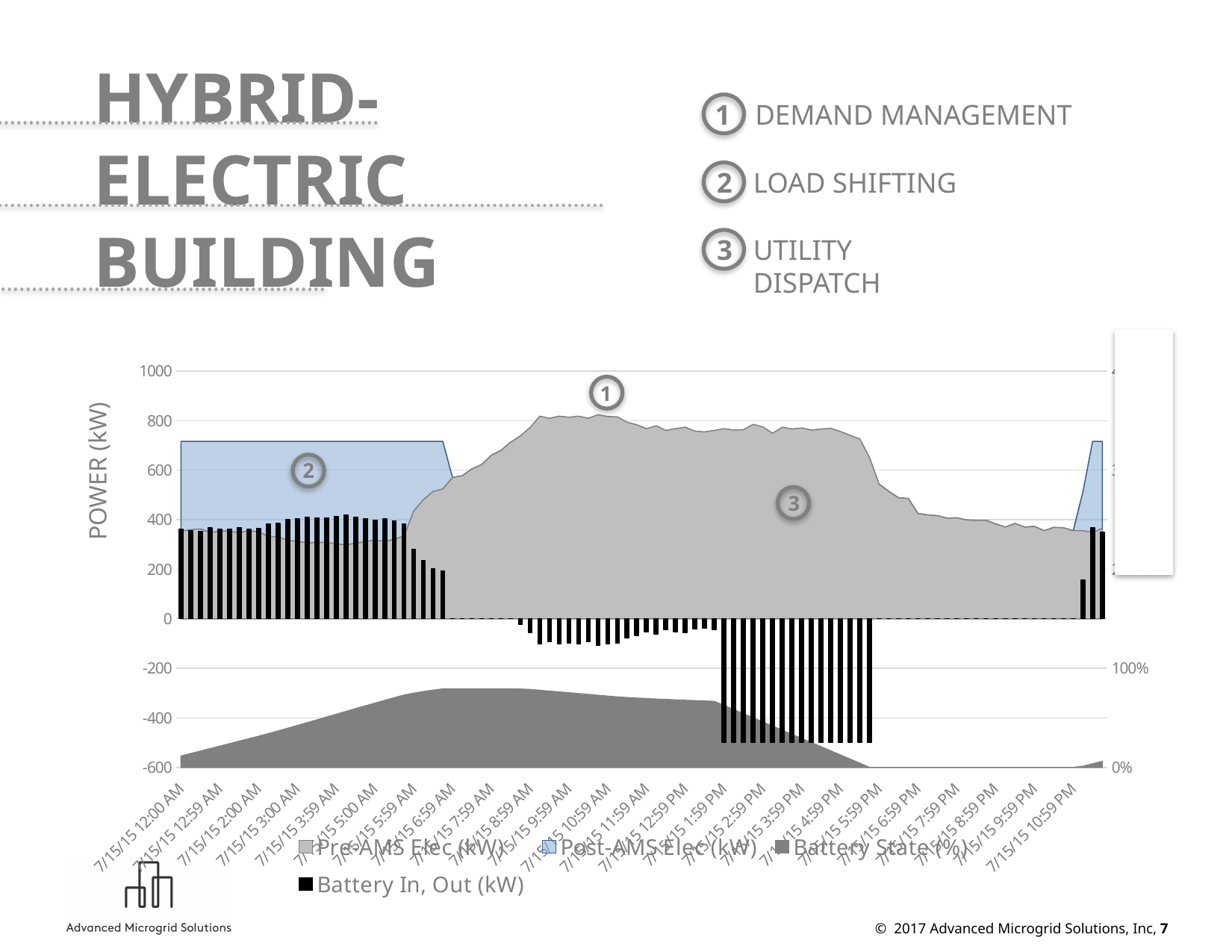
Is the value for Pre-AMS Elec (kW) at 7/15/15 12:00 AM greater or less than 600? less What kind of chart is shown on the slide? a combined area and bar chart Is the value for Post-AMS Elec (kW) at 7/15/15 12:00 AM greater or less than 600? greater Which is larger for Pre-AMS Elec (kW): the value at 7/15/15 9:59 AM or at 7/15/15 12:00 AM? 7/15/15 9:59 AM How many series does the chart legend list? 4 At 7/15/15 12:00 AM, which series has the larger value: Pre-AMS Elec (kW) or Post-AMS Elec (kW)? Post-AMS Elec (kW) Is the value for Battery In, Out (kW) at 7/15/15 2:59 PM greater or less than -400? less What is the label on the left vertical axis of the chart? POWER (kW) Which series in the legend is shown in blue? Post-AMS Elec (kW) Does the Battery State (%) series rise or fall between 7/15/15 12:00 AM and 7/15/15 6:59 AM? rise